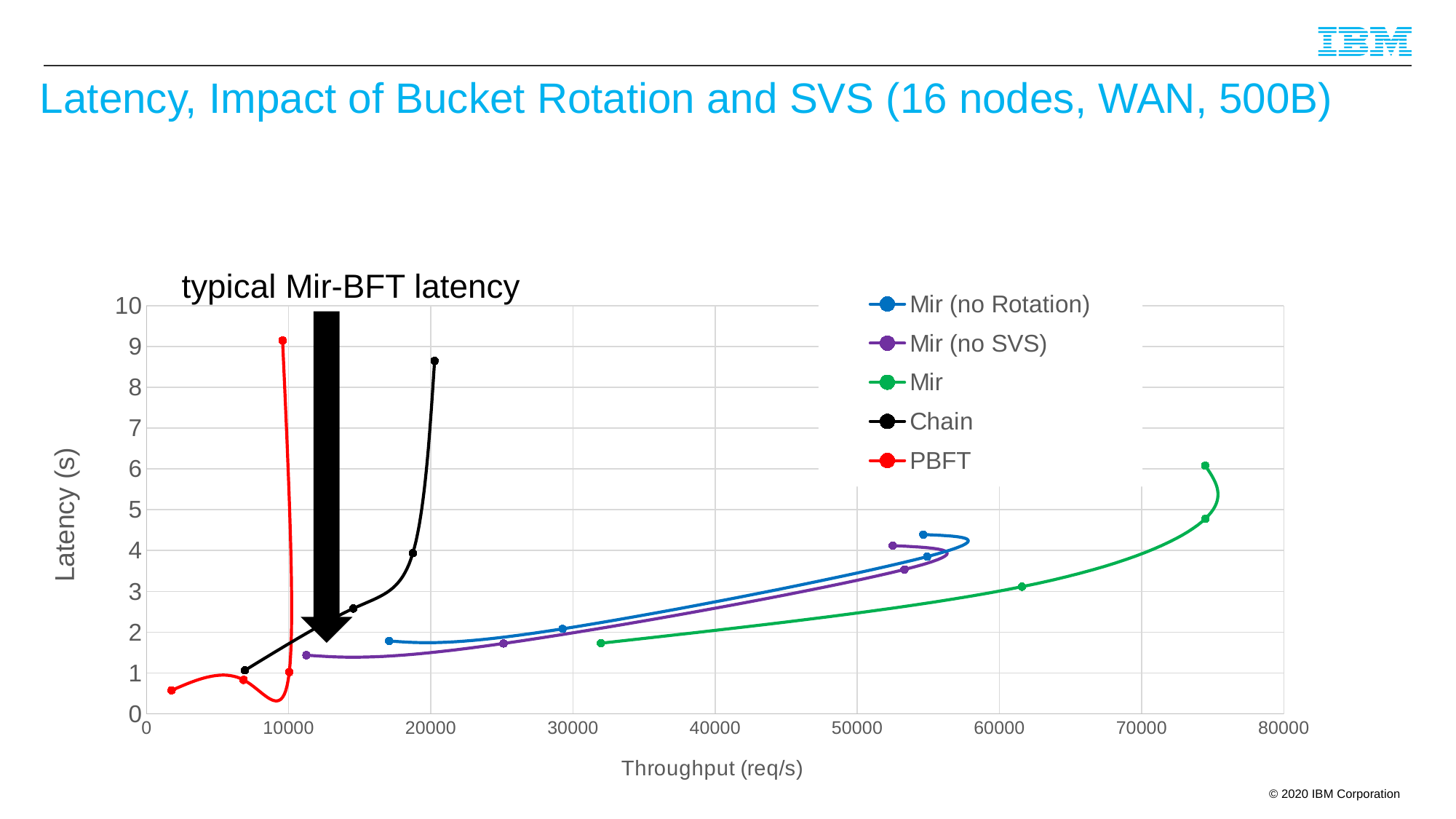
Which series reaches the highest throughput? Mir What is the title of the chart on the slide? Latency, Impact of Bucket Rotation and SVS (16 nodes, WAN, 500B) What kind of chart is shown on the slide? line chart Is the maximum throughput reached by the Mir series greater or less than 70000? greater Which series reaches the highest latency? PBFT How many series does the legend list? 5 Is the maximum throughput reached by the PBFT series greater or less than 20000? less Is the lowest latency of the Mir (no SVS) series greater or less than 2? less Which series reaches a higher throughput, Mir or Chain? Mir For the Mir series, does latency rise or fall as throughput increases? rise What is the label of the x axis? Throughput (req/s)